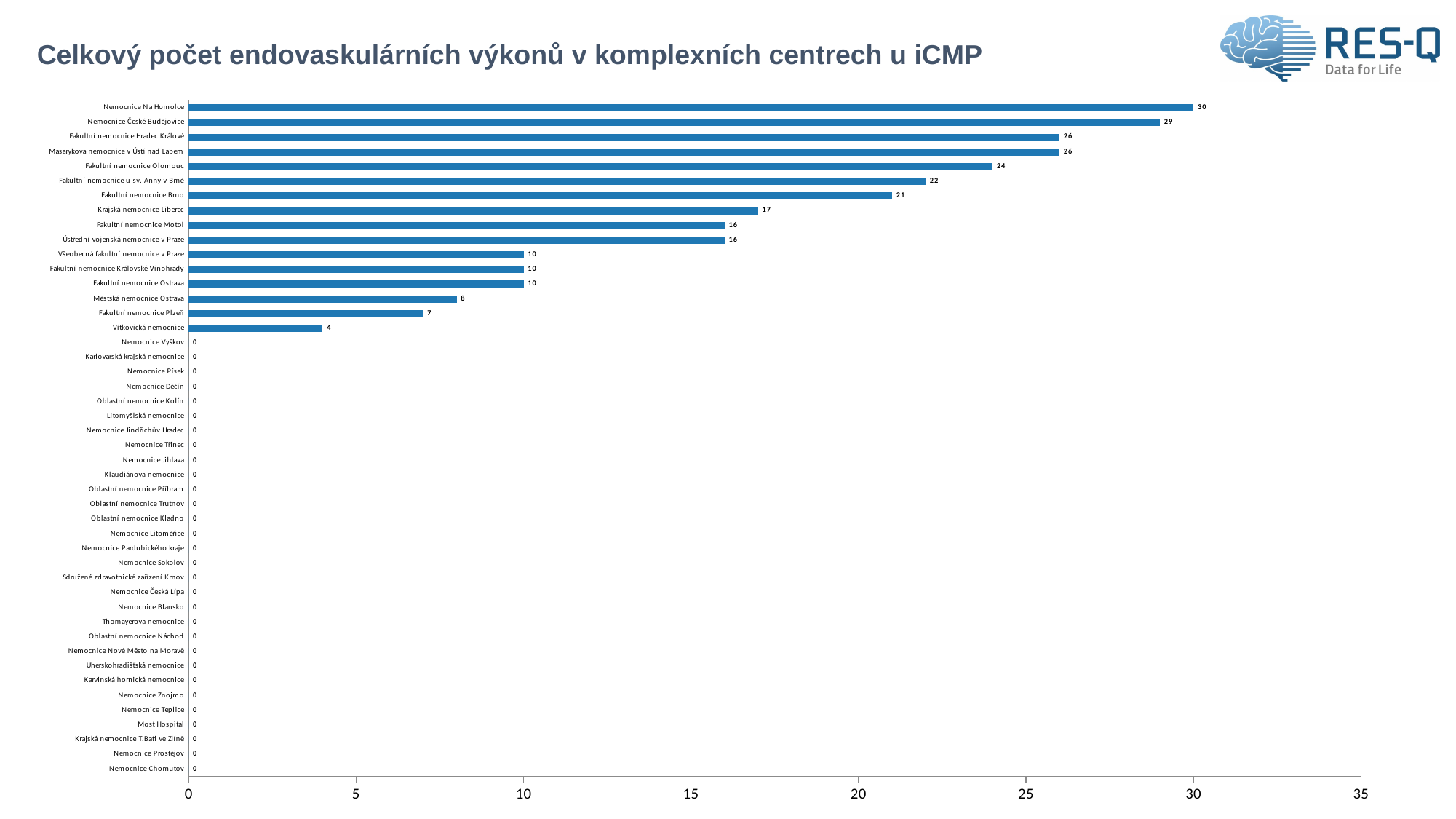
What is the value for Nemocnice Na Homolce? 30 Which hospital has the highest value? Nemocnice Na Homolce How many hospitals have a value greater than 0? 16 What is the difference between Nemocnice České Budějovice and Fakultní nemocnice Brno? 8 Which is larger, the value for Fakultní nemocnice Motol or the value for Městská nemocnice Ostrava? Fakultní nemocnice Motol What is the value for Vítkovická nemocnice? 4 Is the value for Fakultní nemocnice u sv. Anny v Brně greater or less than 20? greater What is the value for Fakultní nemocnice Olomouc? 24 What is the title of the chart? Celkový počet endovaskulárních výkonů v komplexních centrech u iCMP What is the value for Krajská nemocnice Liberec? 17 How many hospitals are listed on the chart? 46 What kind of chart is shown? bar chart